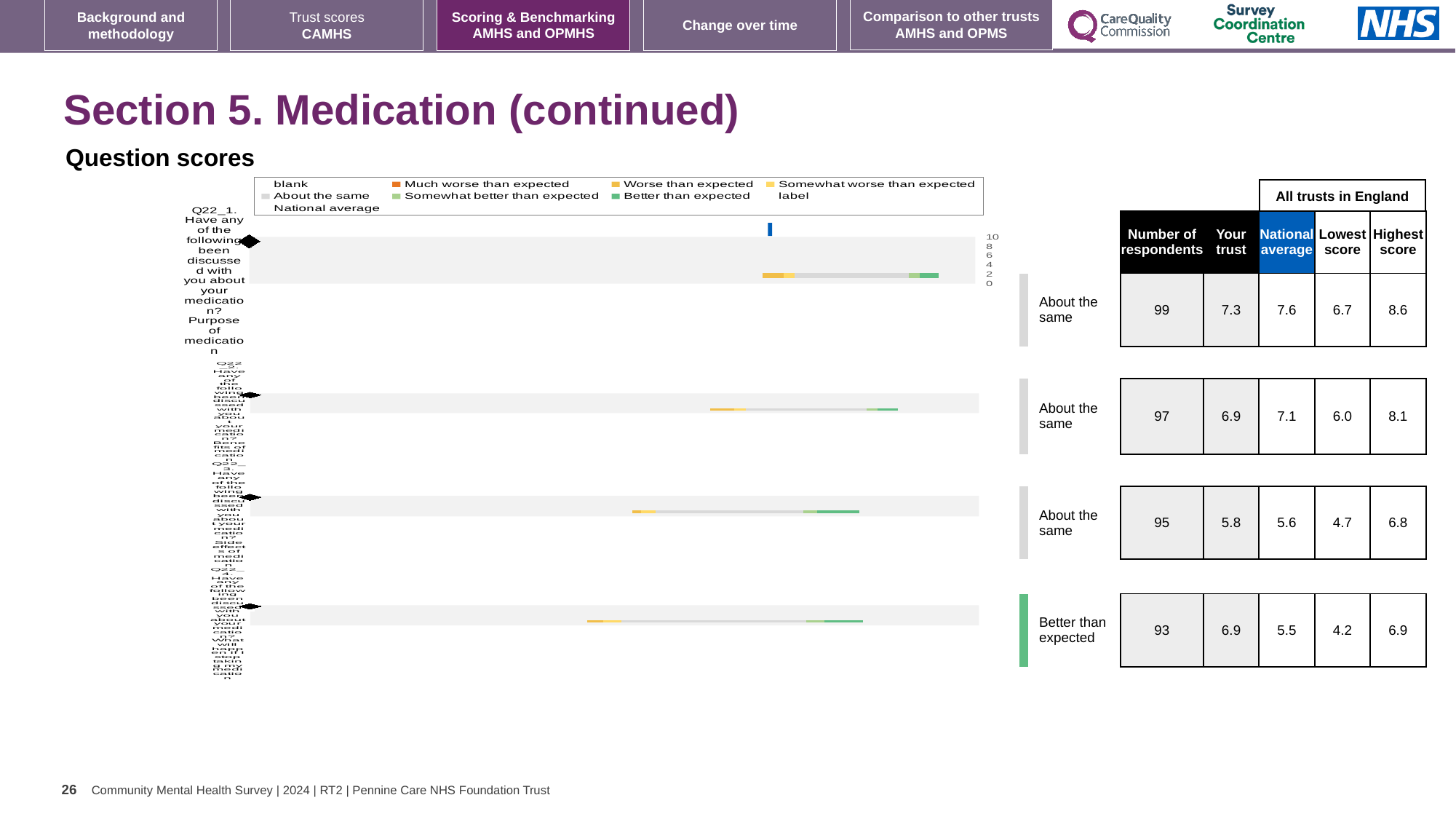
In the table beside the chart, what is the national average for the third row? 5.6 In the chart legend, what colour represents 'Better than expected'? green Which row has the highest number of respondents? The first (top) row, with 99 In the table beside the chart, what is the number of respondents for the first (top) row? 99 What kind of chart is shown under 'Question scores'? bar chart How many horizontal bars (question rows) does the chart contain? 4 In the table beside the chart, what is the lowest score for the first row? 6.7 For the first row, which is larger: the 'Your trust' score or the national average? National average In the table beside the chart, what is the highest score for the second row? 8.1 In the table beside the chart, what is the 'Your trust' score for the bottom row, rated 'Better than expected'? 6.9 For the bottom row, what is the difference between the highest score (6.9) and the lowest score (4.2)? 2.7 What is the highest tick value shown on the chart's score axis? 10